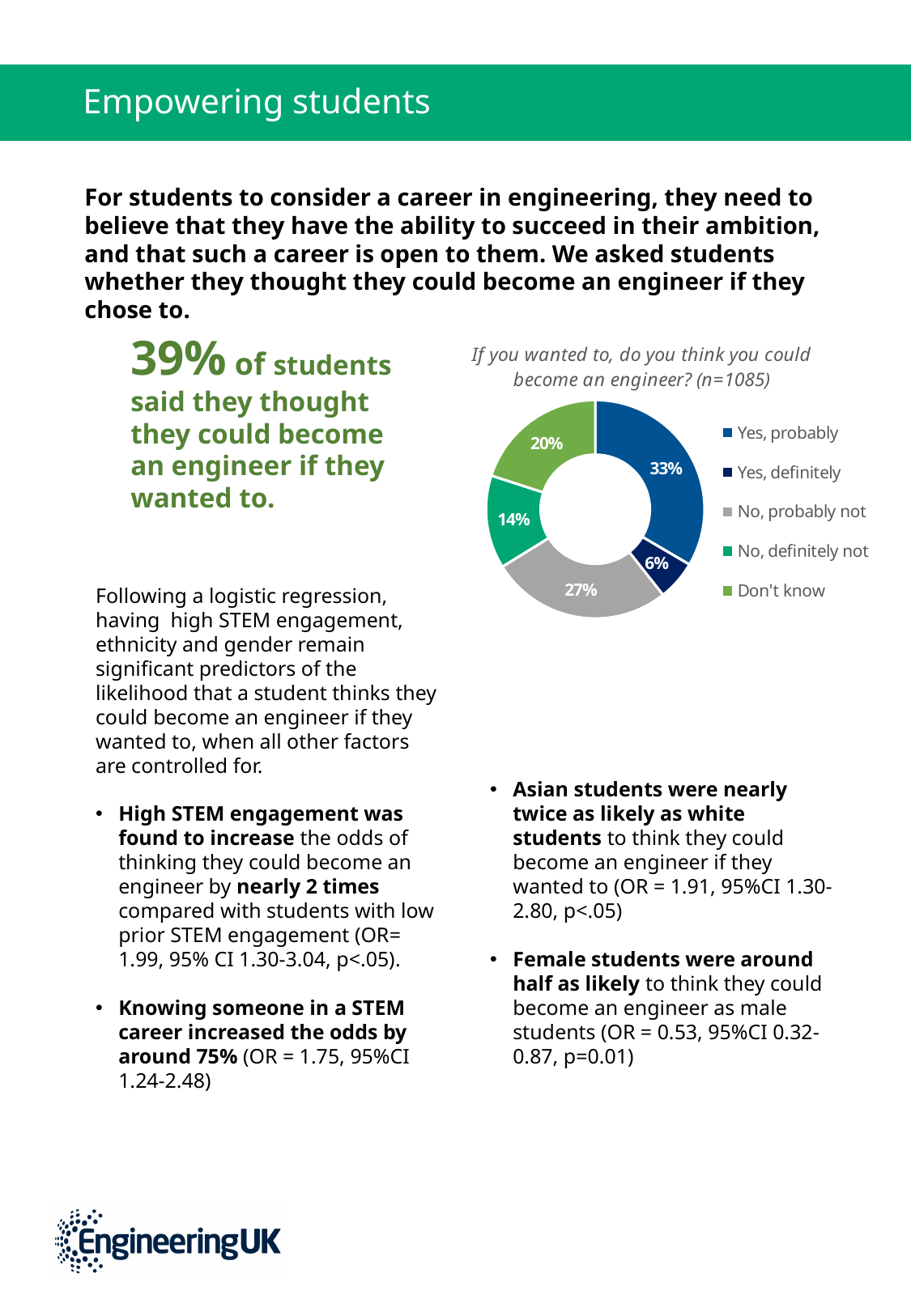
What sample size (n) is given in the chart title? 1085 What kind of chart is shown on the slide? Doughnut (pie) chart What is the difference in percentage points between "No, probably not" and "No, definitely not"? 13 Which response category has the largest share of the chart? Yes, probably What percentage of students answered "No, probably not"? 27% What percentage of students answered "Yes, probably"? 33% What percentage of students answered "Don't know"? 20% What is the combined share of the two "Yes" responses ("Yes, probably" and "Yes, definitely")? 39% Which is larger: the share for "Don't know" or the share for "No, definitely not"? Don't know How many response categories does the chart show? 5 Which response category has the smallest share of the chart? Yes, definitely What percentage of students answered "Yes, definitely"? 6%